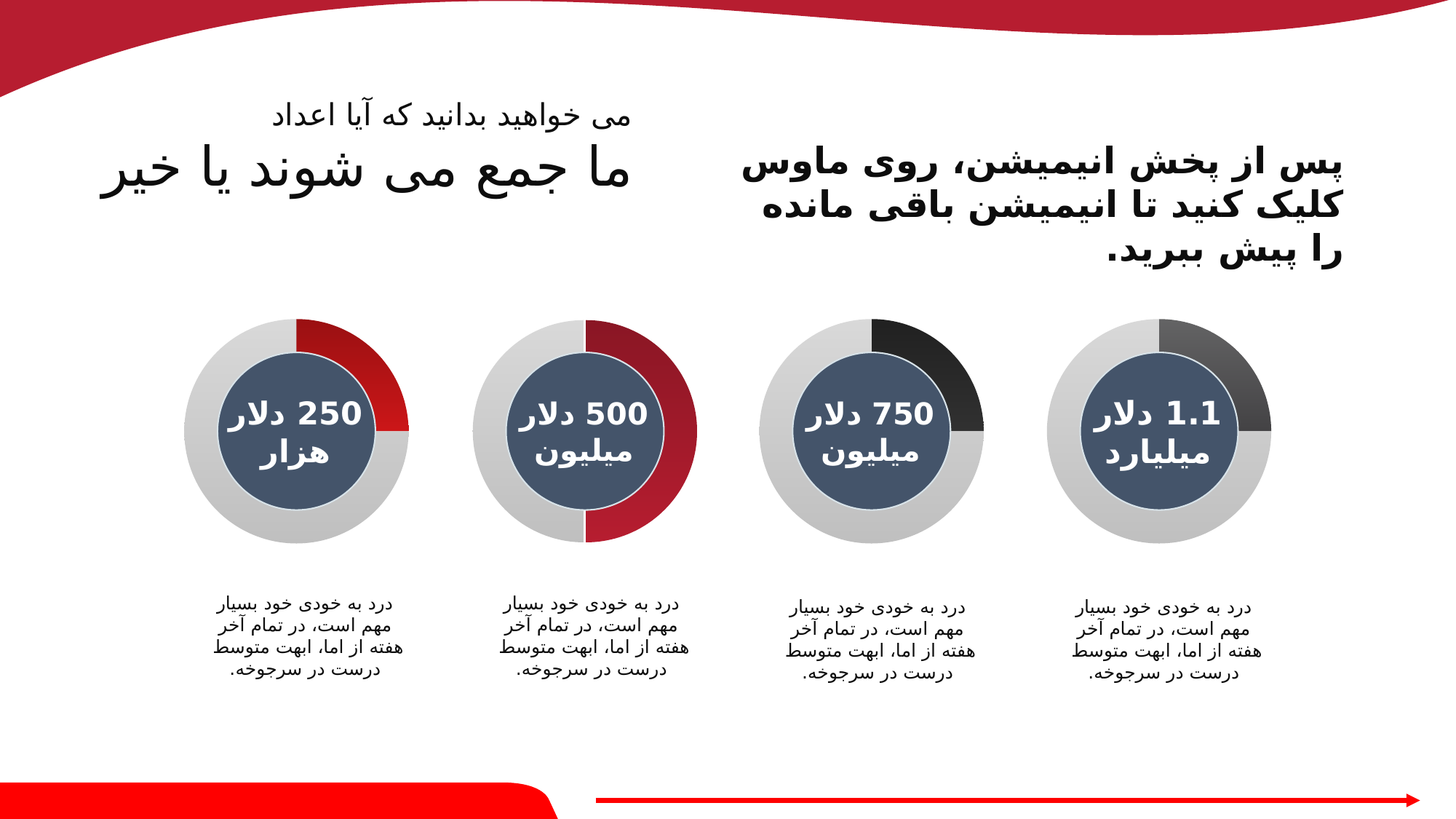
What label is printed in the centre of the rightmost donut chart? 1.1 دلار میلیارد Which donut chart has the largest filled (coloured) portion of its ring? The second from the left (500 دلار میلیون) What colour is the filled portion of the ring in the leftmost donut chart? Red What label is printed in the centre of the leftmost donut chart? 250 دلار هزار What colour is the filled portion of the ring in the third donut chart from the left? Black Which has a larger filled portion of its ring: the leftmost donut chart or the second donut chart from the left? The second from the left How many donut charts are shown on the slide? 4 What kind of chart is used for each of the four graphics on the slide? Donut chart What label is printed in the centre of the third donut chart from the left? 750 دلار میلیون What label is printed in the centre of the second donut chart from the left? 500 دلار میلیون